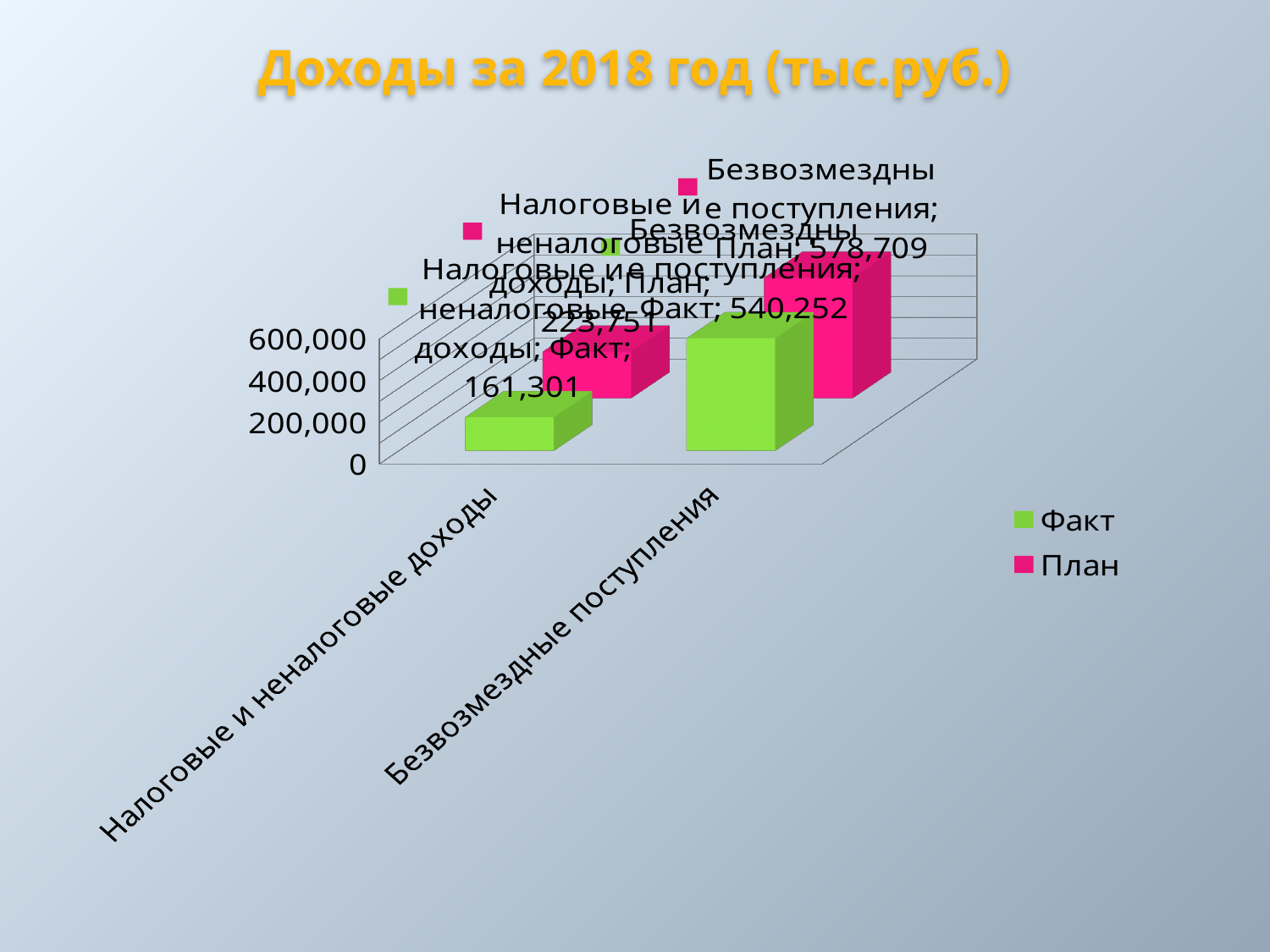
Which is larger for Безвозмездные поступления, Факт or План? План What type of chart is shown on the slide? Bar chart What is the difference between the План and Факт values for Безвозмездные поступления? 38,457 What is the План value for Налоговые и неналоговые доходы? 223,751 What is the План value for Безвозмездные поступления? 578,709 Which category has the highest Факт value? Безвозмездные поступления Which category has the lowest План value? Налоговые и неналоговые доходы What is the Факт value for Налоговые и неналоговые доходы? 161,301 What is the difference between the План and Факт values for Налоговые и неналоговые доходы? 62,450 Is the Факт value for Безвозмездные поступления greater or less than 400,000? greater How many series does the legend list? 2 What is the Факт value for Безвозмездные поступления? 540,252